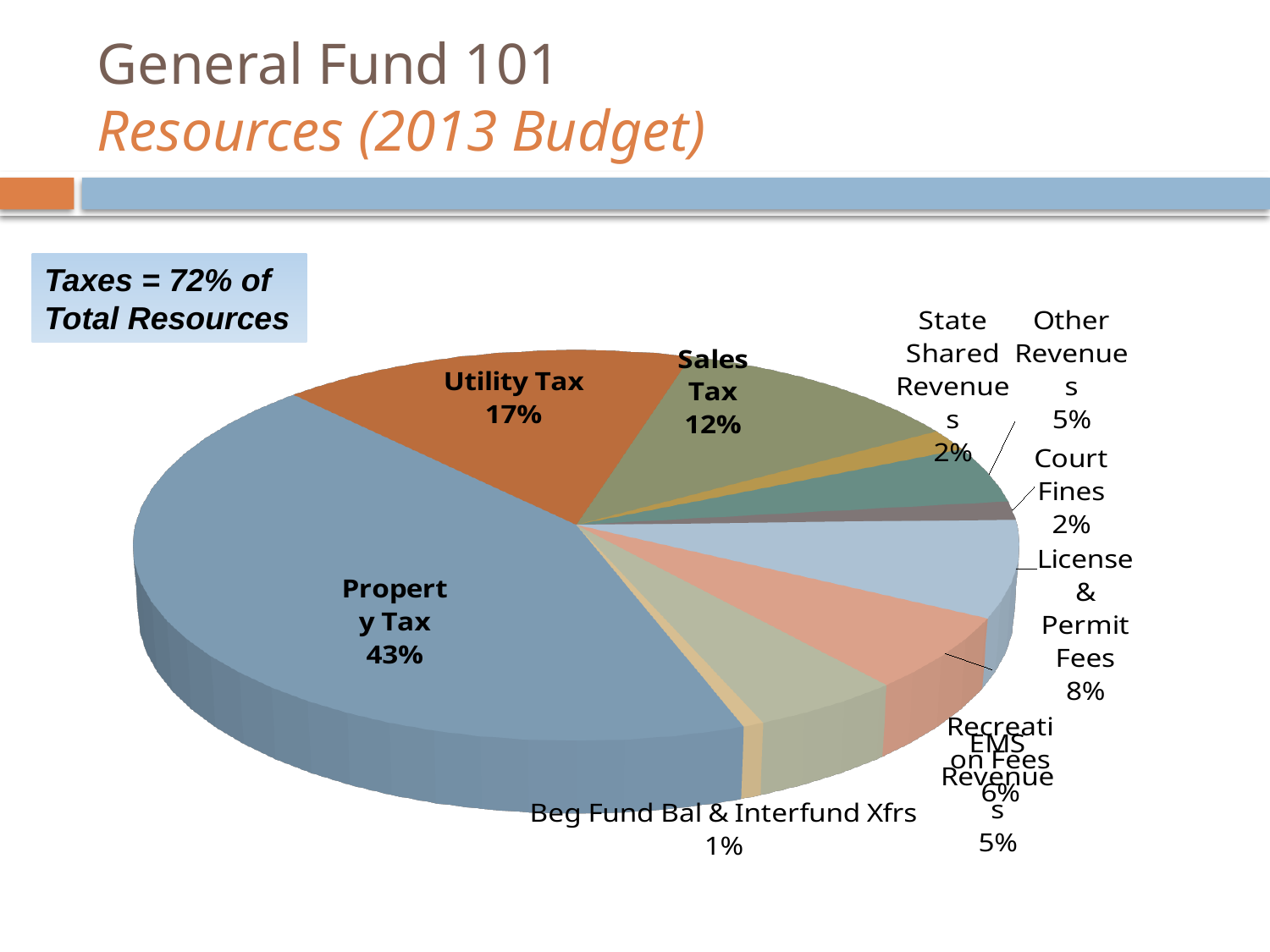
What is the value shown for Sales Tax? 12% What is the value shown for License & Permit Fees? 8% What kind of chart is shown on the slide? pie chart What share of total resources does Property Tax represent? 43% What is the difference in percentage points between Property Tax and Utility Tax? 26 percentage points Which category has the largest slice of the pie? Property Tax What is the value shown for Recreation Fees? 6% Which category has the smallest slice of the pie? Beg Fund Bal & Interfund Xfrs According to the text box on the slide, what percentage of total resources do taxes make up? 72% Which is larger, Sales Tax or License & Permit Fees? Sales Tax How many slices does the pie chart have? 10 What is the value shown for Utility Tax? 17%